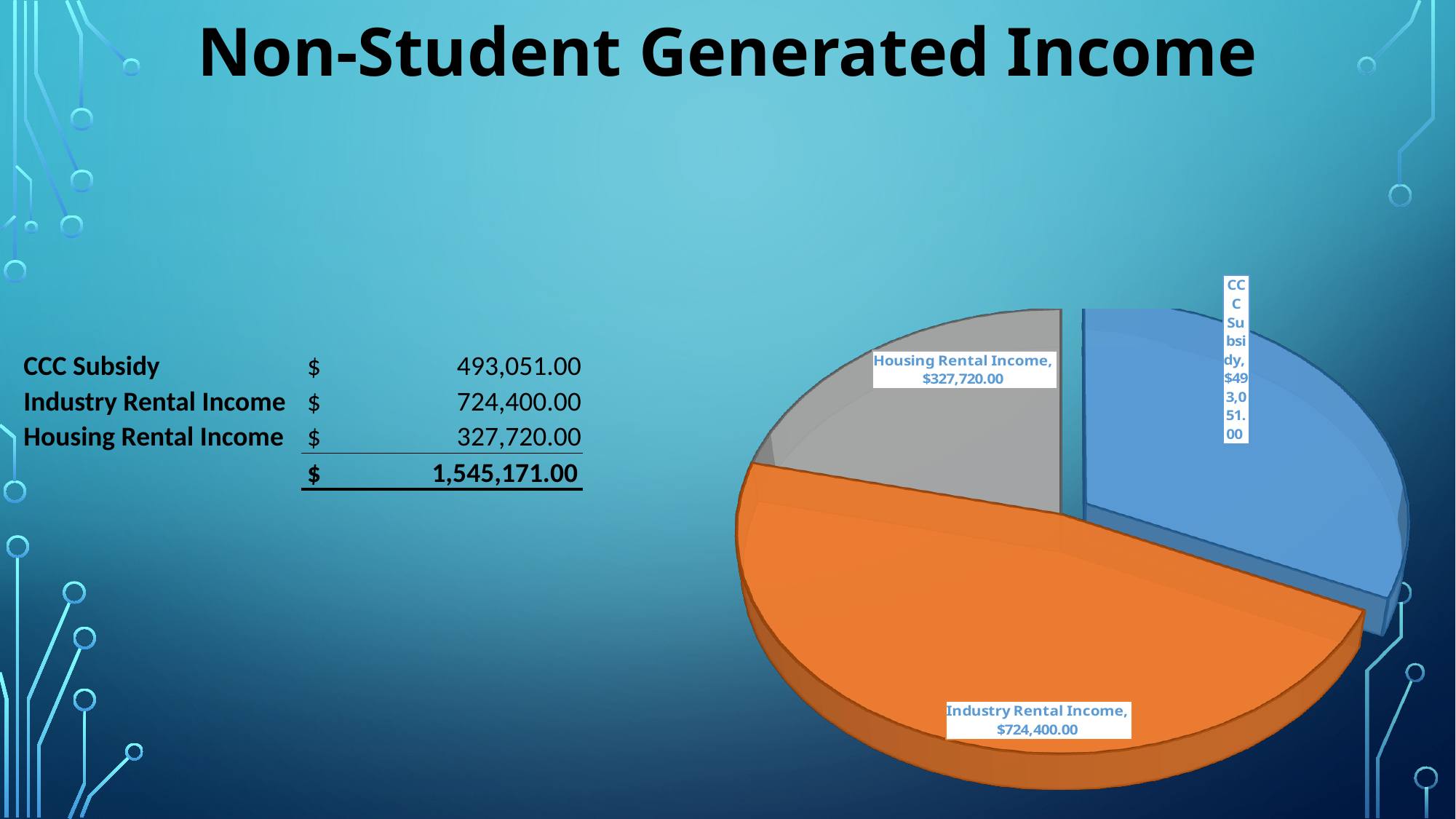
Which category has the largest slice in the pie chart? Industry Rental Income What is the value of the CCC Subsidy slice in the pie chart? $493,051.00 What type of chart is shown on the slide? Pie chart Which category has the smallest slice in the pie chart? Housing Rental Income How many slices does the pie chart have? 3 What is the value of the Housing Rental Income slice in the pie chart? $327,720.00 Which is larger in the pie chart, CCC Subsidy or Housing Rental Income? CCC Subsidy What is the total of all three categories shown on the slide? $1,545,171.00 What colour is the Industry Rental Income slice in the pie chart? Orange What is the difference between CCC Subsidy and Housing Rental Income? $165,331.00 What is the value of the Industry Rental Income slice in the pie chart? $724,400.00 What is the difference between Industry Rental Income and CCC Subsidy? $231,349.00